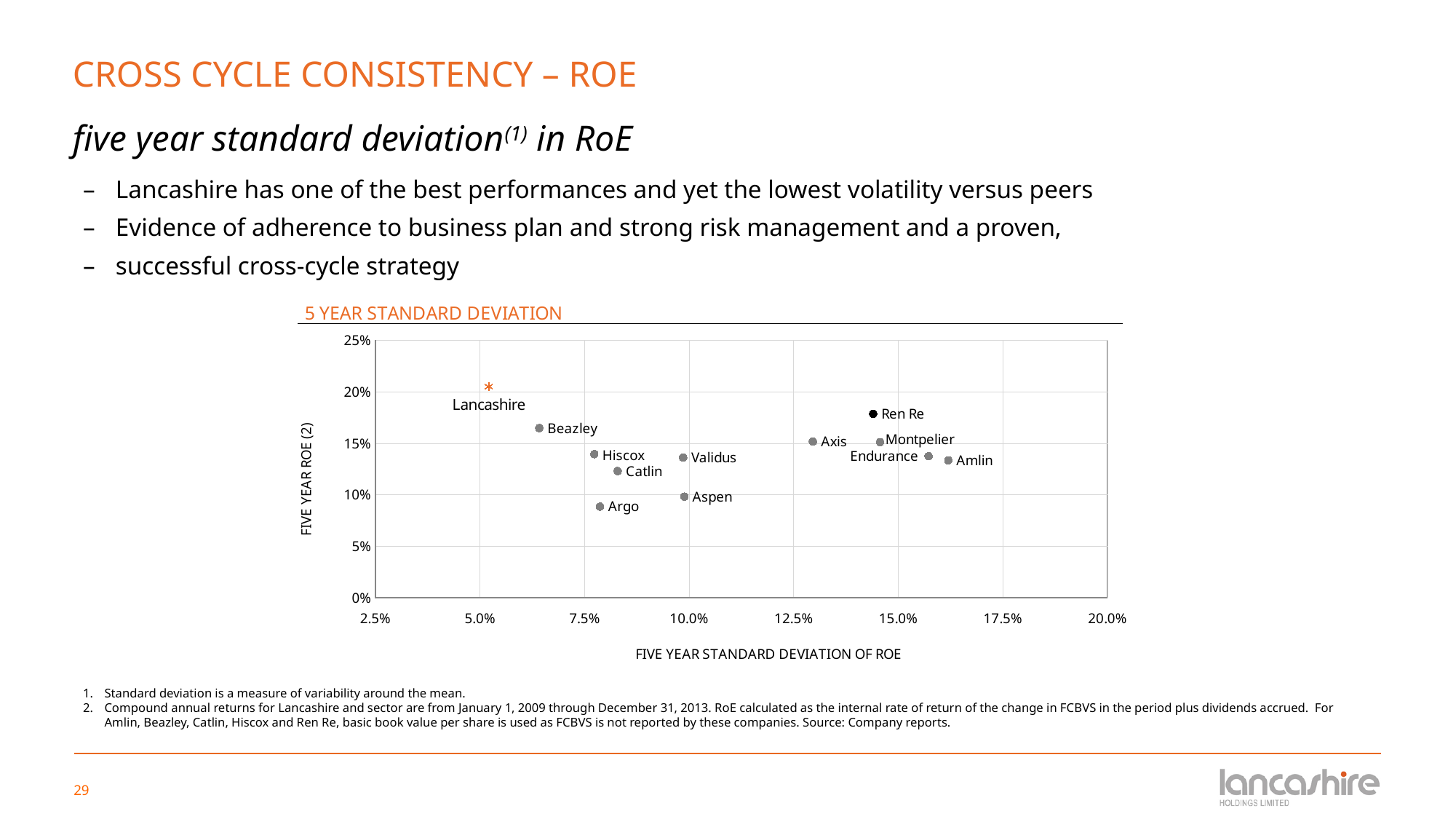
What is the label on the x axis of the chart? FIVE YEAR STANDARD DEVIATION OF ROE Which company has the highest five year standard deviation of ROE on the chart? Amlin Which has the higher five year ROE, Catlin or Validus? Validus Which company has the lowest five year ROE on the chart? Argo What kind of chart is shown on the slide? Scatter chart Which company has the lowest five year standard deviation of ROE on the chart? Lancashire Is the five year ROE for Argo greater or less than 10%? less Which has the higher five year ROE, Ren Re or Axis? Ren Re Which company has the highest five year ROE on the chart? Lancashire Is the five year ROE for Beazley greater or less than 15%? greater Is the five year standard deviation of ROE for Axis greater or less than 12.5%? greater How many companies are plotted on the chart? 12